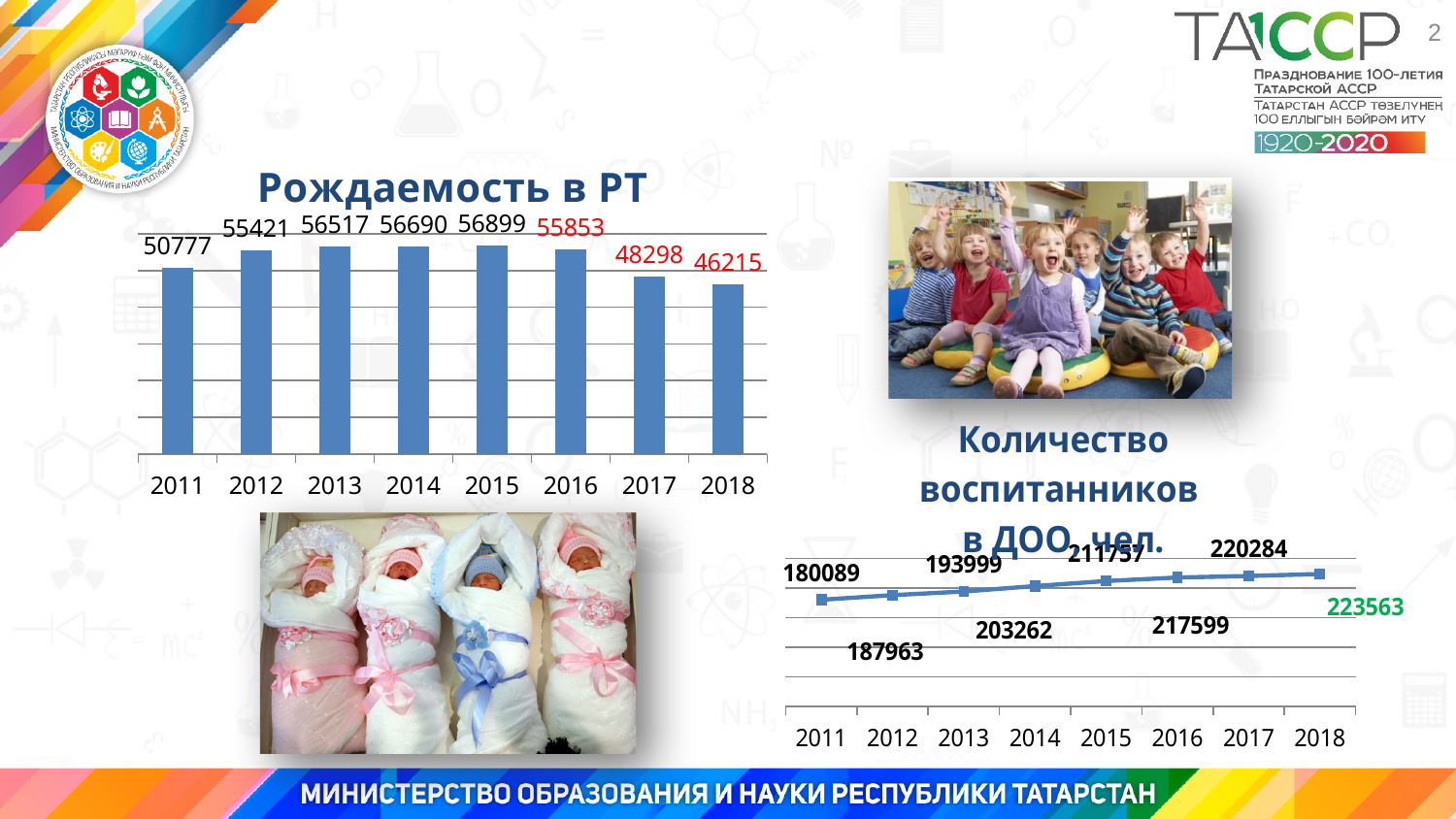
What kind of chart is 'Количество воспитанников в ДОО, чел.'? line chart In the 'Рождаемость в РТ' chart, how many years are shown on the x axis? 8 In the 'Количество воспитанников в ДОО, чел.' chart, do the values rise or fall from 2011 to 2018? rise In the 'Количество воспитанников в ДОО, чел.' chart, what is the value for 2014? 203262 What kind of chart is 'Рождаемость в РТ'? bar chart In the 'Рождаемость в РТ' chart, what is the value for 2018? 46215 In the 'Количество воспитанников в ДОО, чел.' chart, what is the difference between the values for 2018 and 2011? 43474 In the 'Рождаемость в РТ' chart, which year has the highest value? 2015 In the 'Рождаемость в РТ' chart, what is the value for 2011? 50777 In the 'Рождаемость в РТ' chart, which year has the lowest value? 2018 In the 'Рождаемость в РТ' chart, what is the difference between the values for 2016 and 2017? 7555 In the 'Количество воспитанников в ДОО, чел.' chart, what is the value for 2018? 223563